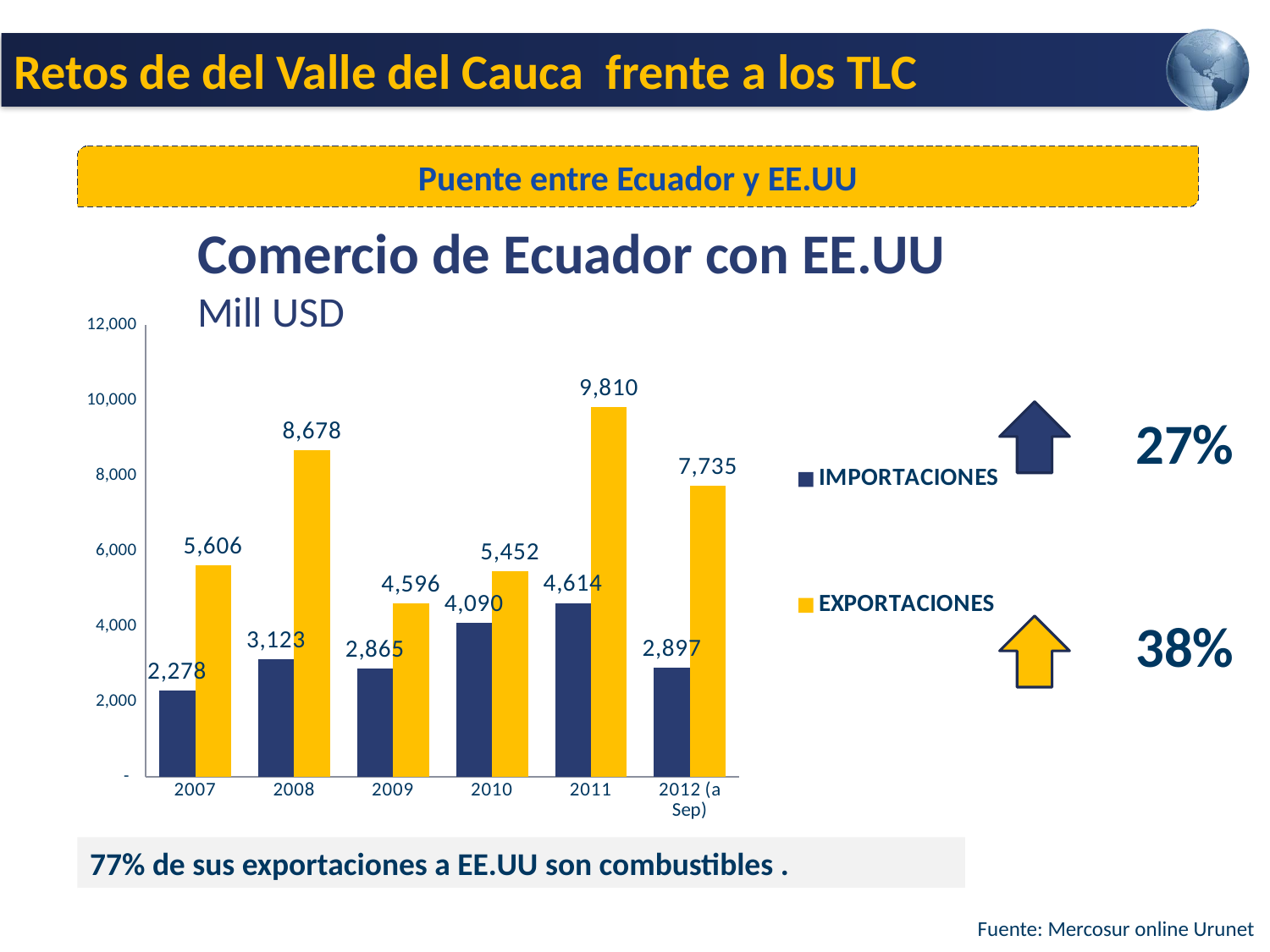
What is the value of EXPORTACIONES for 2012 (a Sep)? 7,735 What is the title of the chart? Comercio de Ecuador con EE.UU Which is larger in 2010, IMPORTACIONES or EXPORTACIONES? EXPORTACIONES What is the value of EXPORTACIONES for 2011? 9,810 How many years (categories) are shown on the x axis? 6 In which year are IMPORTACIONES lowest? 2007 In which year are EXPORTACIONES highest? 2011 Do IMPORTACIONES rise or fall from 2009 to 2011? Rise What type of chart is shown on the slide? Bar chart What is the difference between EXPORTACIONES and IMPORTACIONES in 2008? 5,555 What is the value of IMPORTACIONES for 2007? 2,278 How many series does the legend list? 2